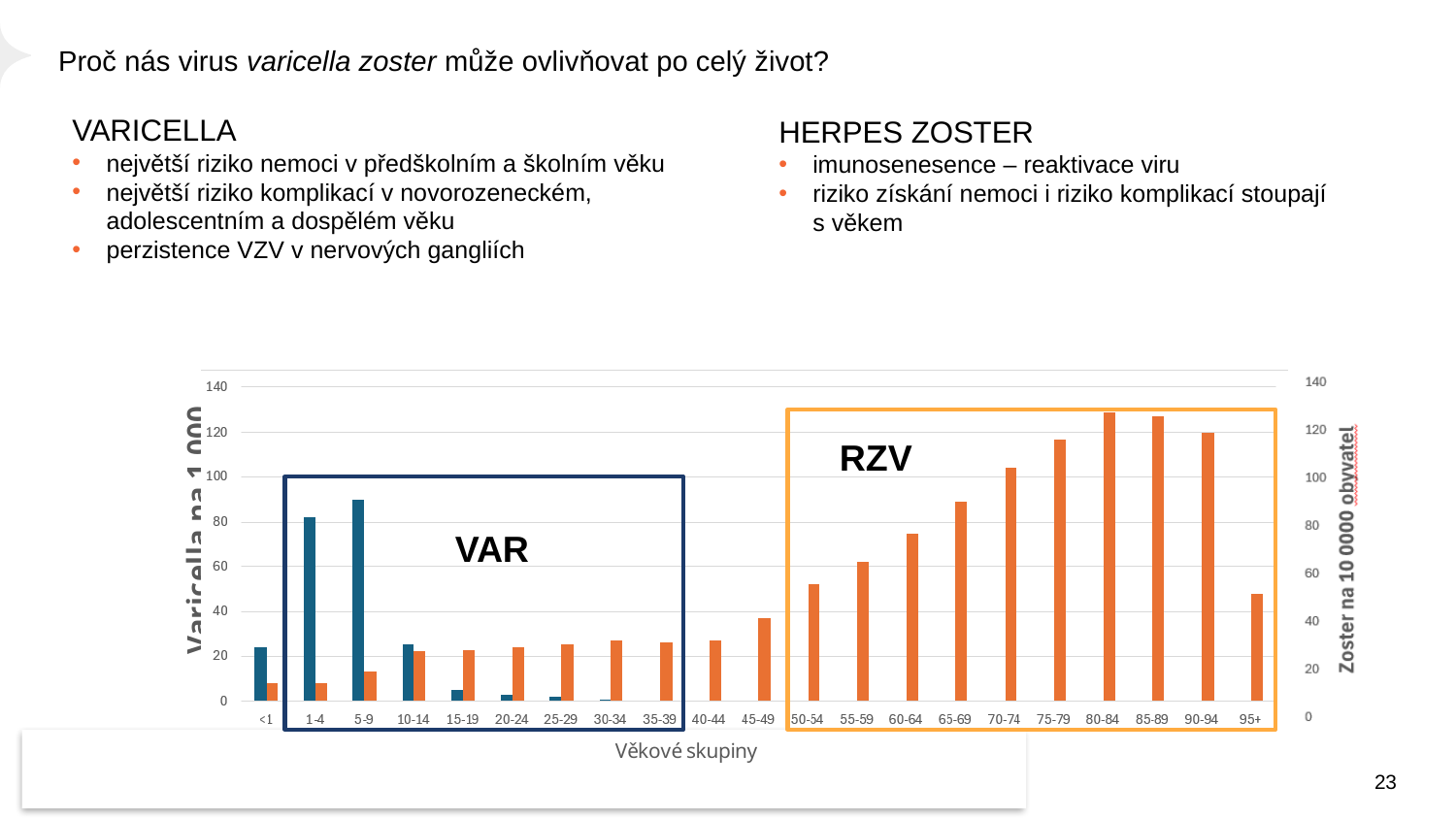
Is the blue (Varicella) value for the 5-9 age group greater or less than 80? greater Do the orange (Zoster) bars rise or fall from the 50-54 age group to the 80-84 age group? rise What is the title of the x axis of the chart? Věkové skupiny How many age-group categories are shown on the x axis of the chart? 21 Which is larger: the blue (Varicella) bar for 1-4 or the blue bar for 5-9? 5-9 Which age group has the highest blue (Varicella) bar? 5-9 What kind of chart is shown on the slide? bar chart Is the orange (Zoster) value for the 90-94 age group greater or less than 100? greater Which is larger: the orange (Zoster) bar for 50-54 or the orange bar for 60-64? 60-64 Is the orange (Zoster) value for the 80-84 age group greater or less than 120? greater What label is written inside the orange box on the chart? RZV